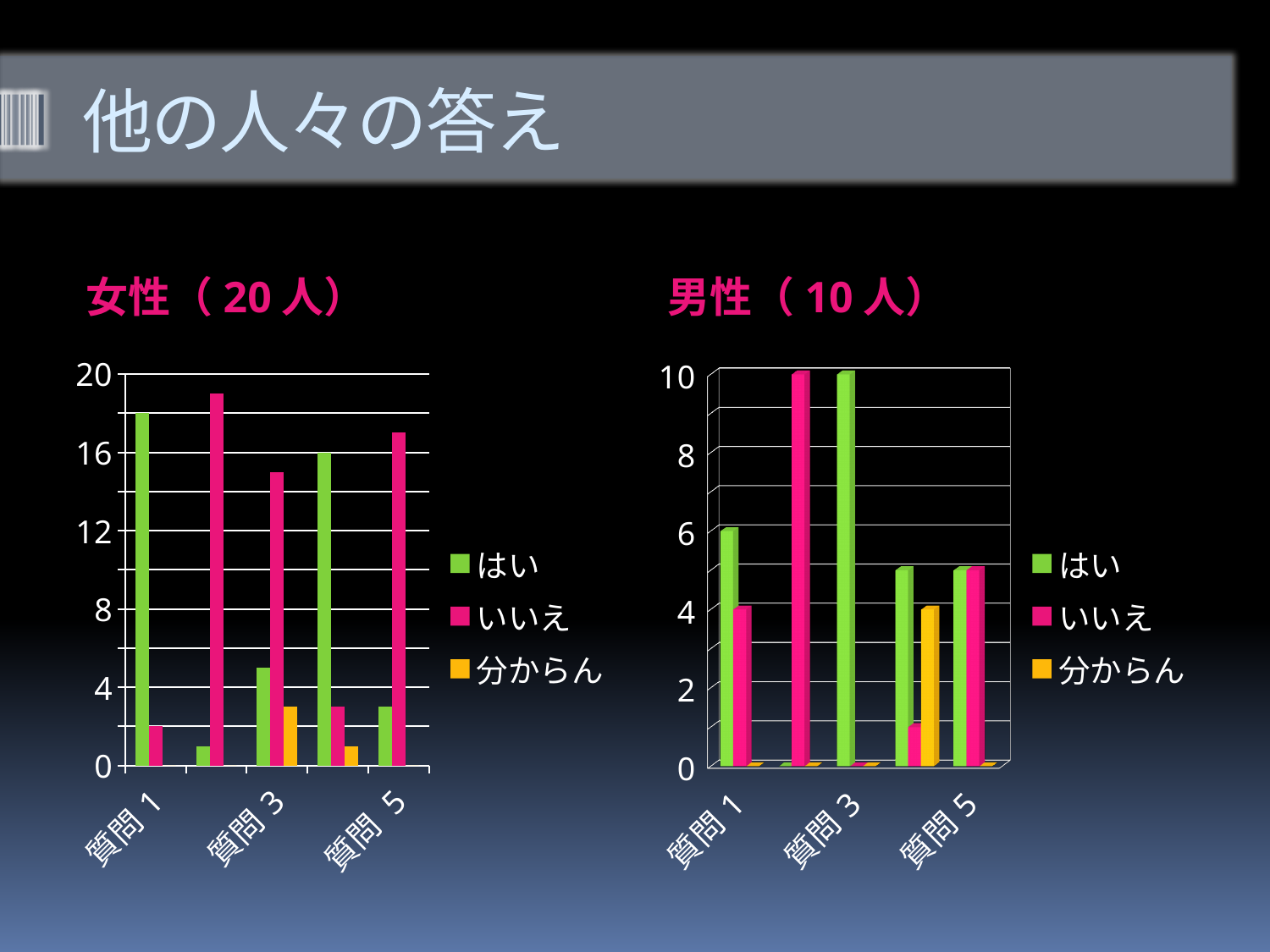
In the 女性（20人） chart, is the value of はい for 質問1 greater or less than 16? greater In the 男性（10人） chart, what is the difference between はい and いいえ for 質問1? 2 In the 女性（20人） chart, is the value of いいえ for 質問3 greater or less than 12? greater What kind of chart is the 女性（20人） chart on the left? bar chart In the 男性（10人） chart, what is the value of はい for 質問3? 10 In the 男性（10人） chart, which series has the highest value for 質問1? はい In the 男性（10人） chart, what is the value of いいえ for 質問1? 4 In the 女性（20人） chart, which is larger for 質問1, はい or いいえ? はい In the 女性（20人） chart, which is larger for 質問3, はい or いいえ? いいえ How many question groups are plotted along the x axis of the 女性（20人） chart? 5 How many series does the legend of the 男性（10人） chart list? 3 In the 男性（10人） chart, what is the value of はい for 質問1? 6